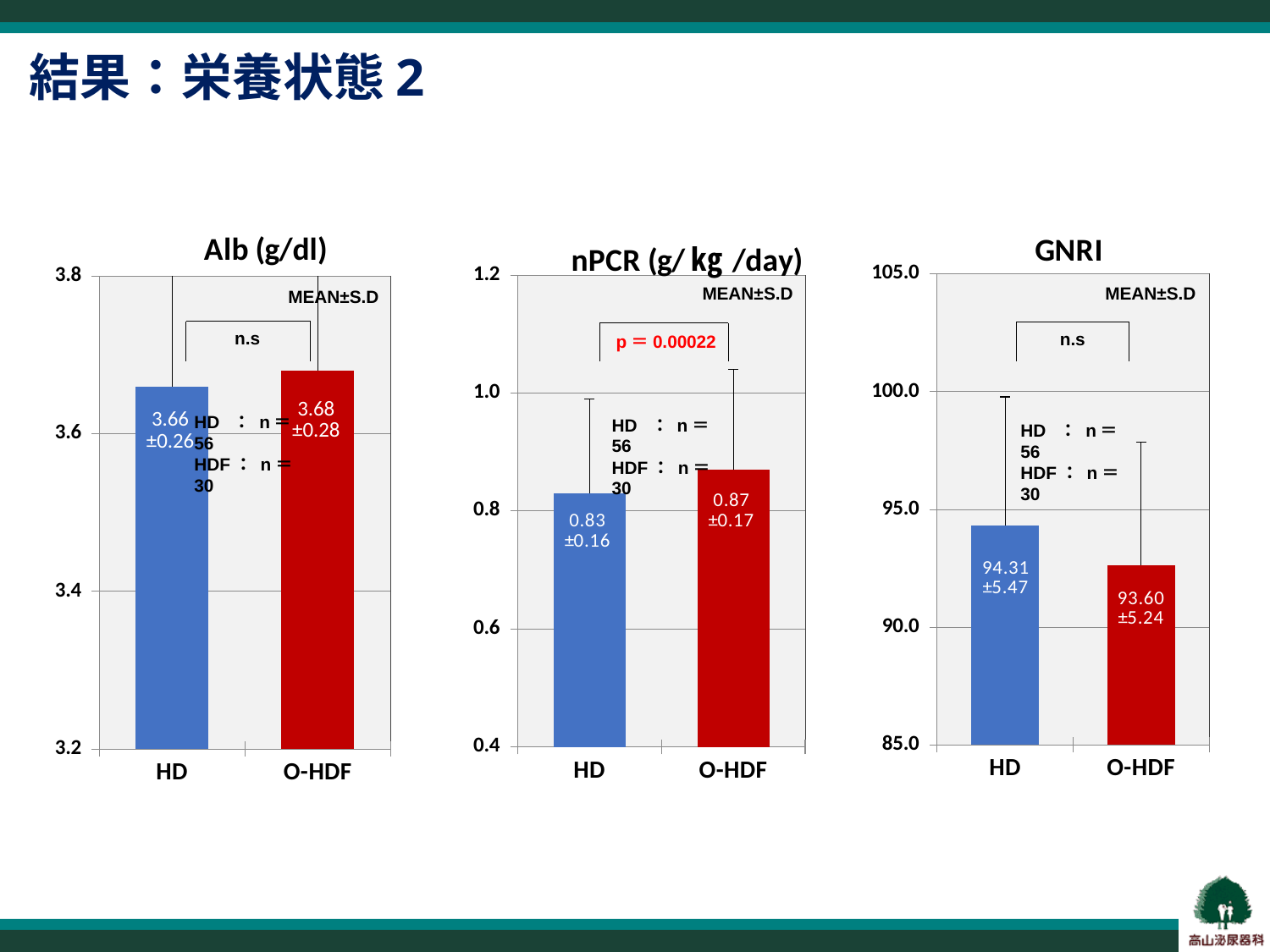
What kind of chart is the Alb (g/dl) chart? bar chart In the GNRI chart, what is the mean value shown for HD? 94.31 In the GNRI chart, is the mean value for O-HDF greater or less than 95.0? less In the nPCR (g/kg/day) chart, what p-value is shown between HD and O-HDF? p = 0.00022 In the GNRI chart, what is the difference between the HD mean and the O-HDF mean? 0.71 In the nPCR (g/kg/day) chart, what is the mean value shown for HD? 0.83 In the Alb (g/dl) chart, what is the mean value shown for O-HDF? 3.68 In the nPCR (g/kg/day) chart, what is the difference between the O-HDF mean and the HD mean? 0.04 In the GNRI chart, which group has the higher mean value, HD or O-HDF? HD In the Alb (g/dl) chart, what is the mean value shown for HD? 3.66 In the GNRI chart, what is the mean value shown for O-HDF? 93.60 In the nPCR (g/kg/day) chart, what is the mean value shown for O-HDF? 0.87